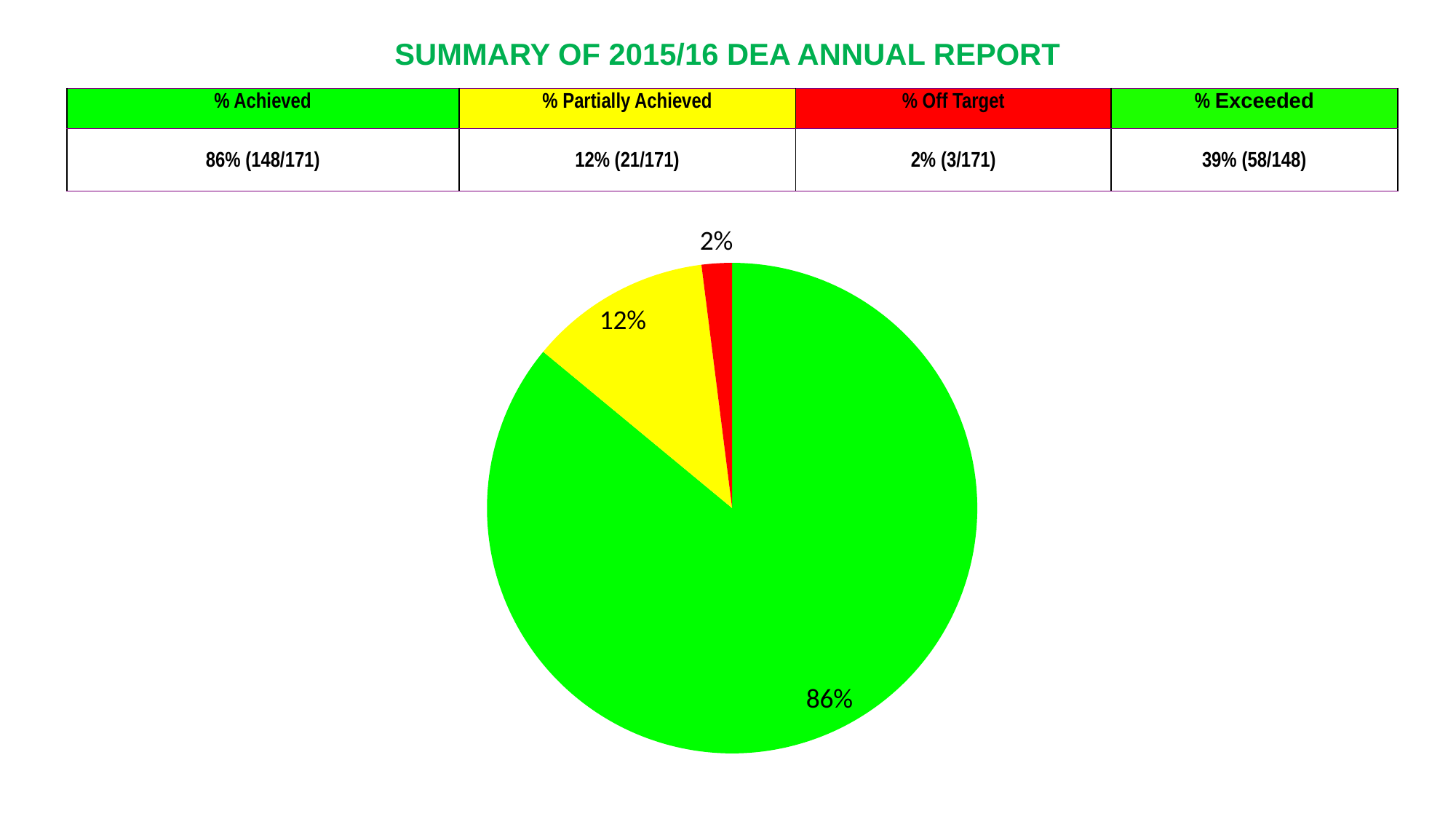
How many slices does the pie chart have? 3 What is the difference between the yellow slice and the red slice of the pie chart? 10% What is the difference between the green slice and the yellow slice of the pie chart? 74% What percentage is shown on the yellow slice of the pie chart? 12% What kind of chart is shown on the slide? pie chart What percentage is shown on the green slice of the pie chart? 86% What colour is the slice labelled 12% in the pie chart? yellow Which slice of the pie chart is the largest? the green slice (86%) What share of the pie does the green slice represent? 86% Which slice of the pie chart is the smallest? the red slice (2%) Which is larger in the pie chart, the yellow slice or the red slice? the yellow slice What percentage is shown on the red slice of the pie chart? 2%